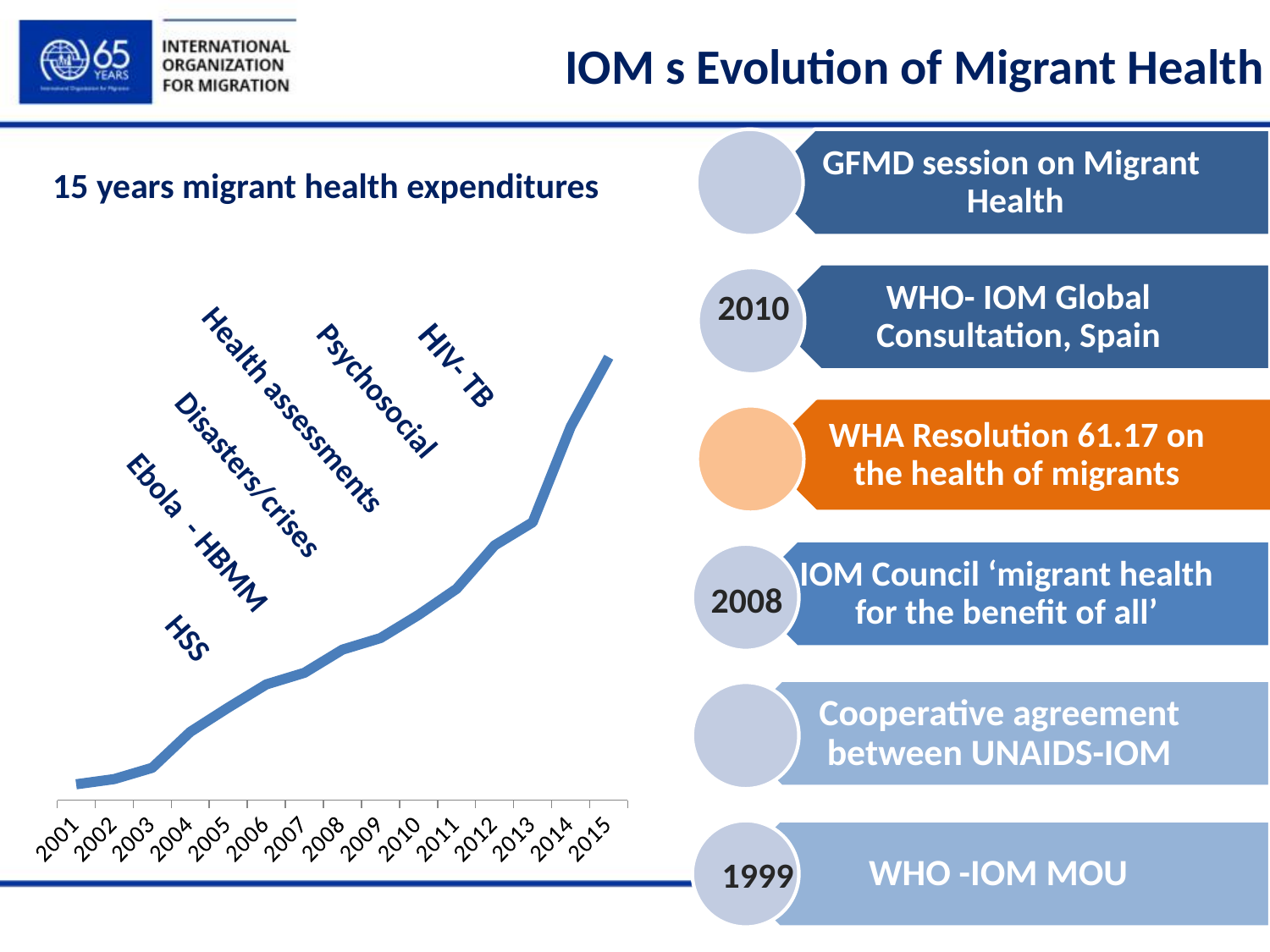
In which year is the migrant health expenditure highest in the chart? 2015 How many years are shown on the x axis of the migrant health expenditures chart? 15 What is the first year shown on the x axis of the migrant health expenditures chart? 2001 What kind of chart is shown under the heading "15 years migrant health expenditures"? line chart Between which two consecutive years does the line in the migrant health expenditures chart rise most steeply? 2013 and 2014 What is the title of the chart on the left of the slide? 15 years migrant health expenditures Which year has the larger migrant health expenditure in the chart, 2005 or 2013? 2013 Which year has the larger migrant health expenditure in the chart, 2010 or 2003? 2010 Do migrant health expenditures rise or fall from 2001 to 2015 in the chart? rise In which year is the migrant health expenditure lowest in the chart? 2001